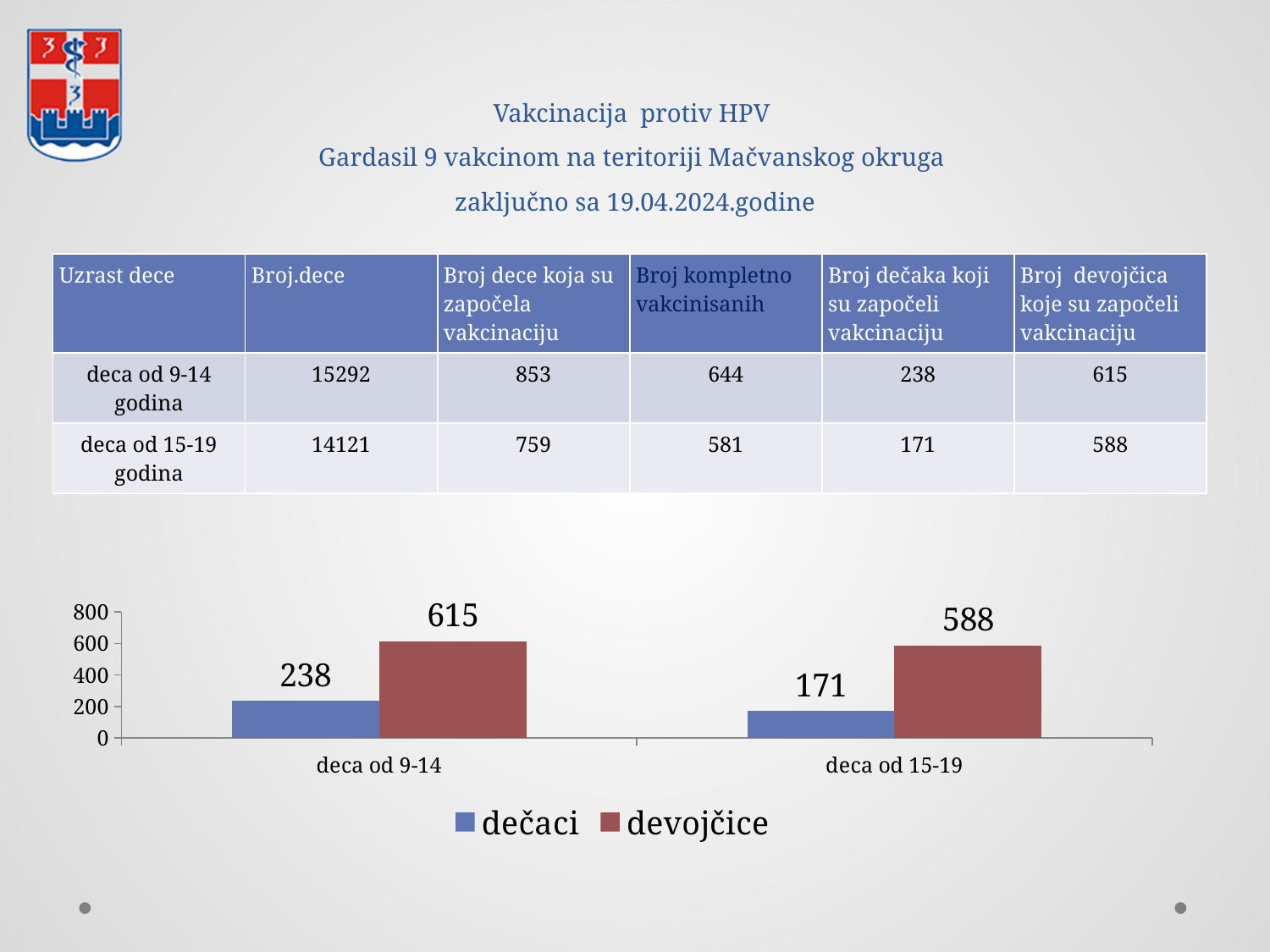
What is the value for dečaci in the deca od 9-14 category? 238 What is the value for devojčice in the deca od 9-14 category? 615 Which category has the highest value for dečaci? deca od 9-14 Which colour represents the devojčice series in the chart? red What is the difference between devojčice and dečaci in the deca od 9-14 category? 377 Which category has the lowest value for devojčice? deca od 15-19 Which is larger in the deca od 15-19 category, dečaci or devojčice? devojčice What is the difference between the dečaci values for deca od 9-14 and deca od 15-19? 67 How many categories are shown on the x axis of the chart? 2 How many series does the chart legend list? 2 What kind of chart is shown on the slide? bar chart What is the value for devojčice in the deca od 15-19 category? 588